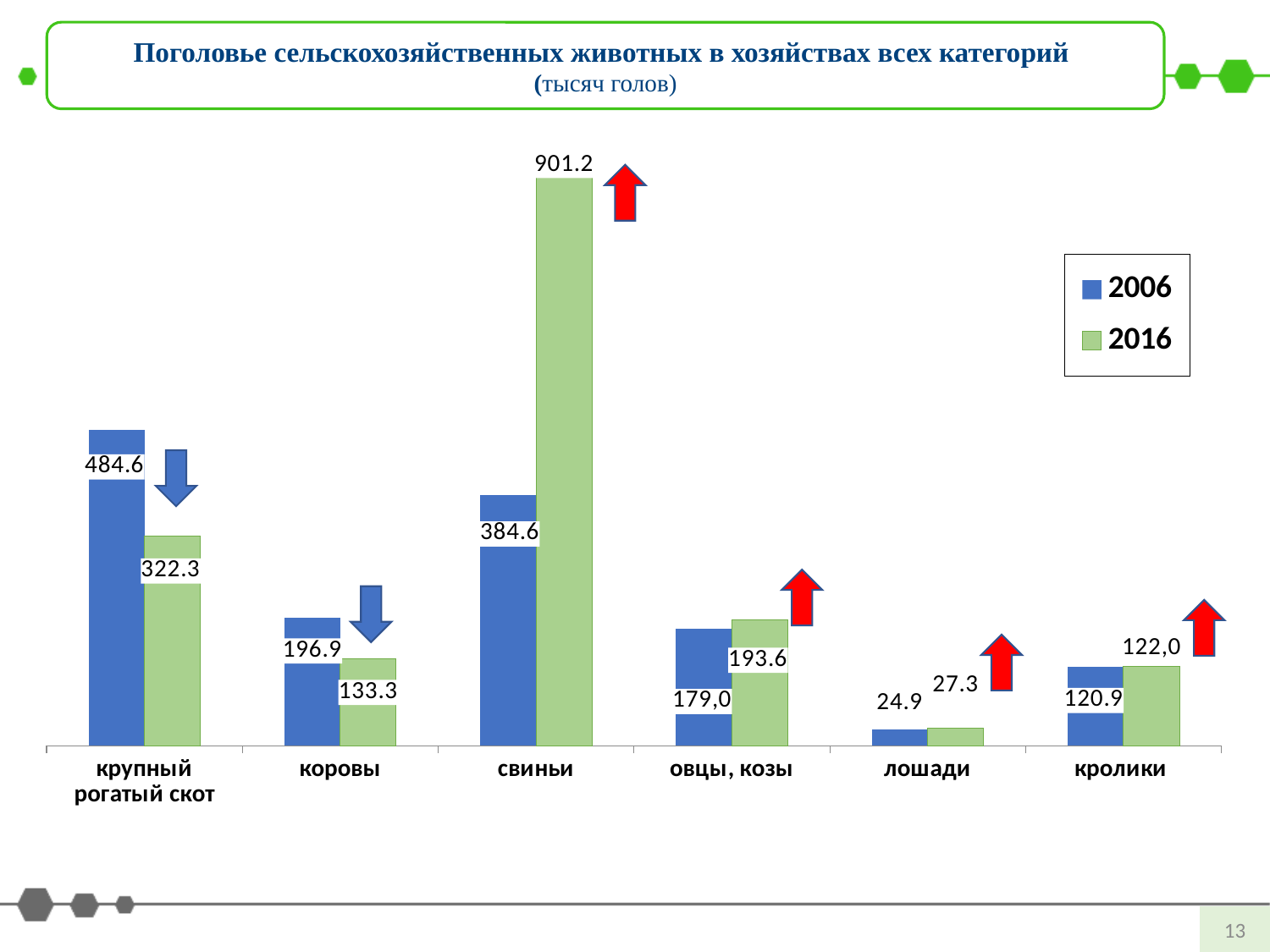
Which category has the lowest value in 2006? лошади Which is larger for коровы: the 2006 value or the 2016 value? 2006 How many series does the legend list? 2 What is the difference between the 2016 and 2006 values for свиньи? 516.6 What kind of chart is shown on the slide? bar chart Which category has the highest value in 2016? свиньи What is the value for овцы, козы in 2006? 179,0 What is the value for крупный рогатый скот in 2006? 484.6 How many categories are shown on the x axis? 6 What is the value for свиньи in 2016? 901.2 What is the value for кролики in 2016? 122,0 Which colour represents the 2016 series in the legend? green